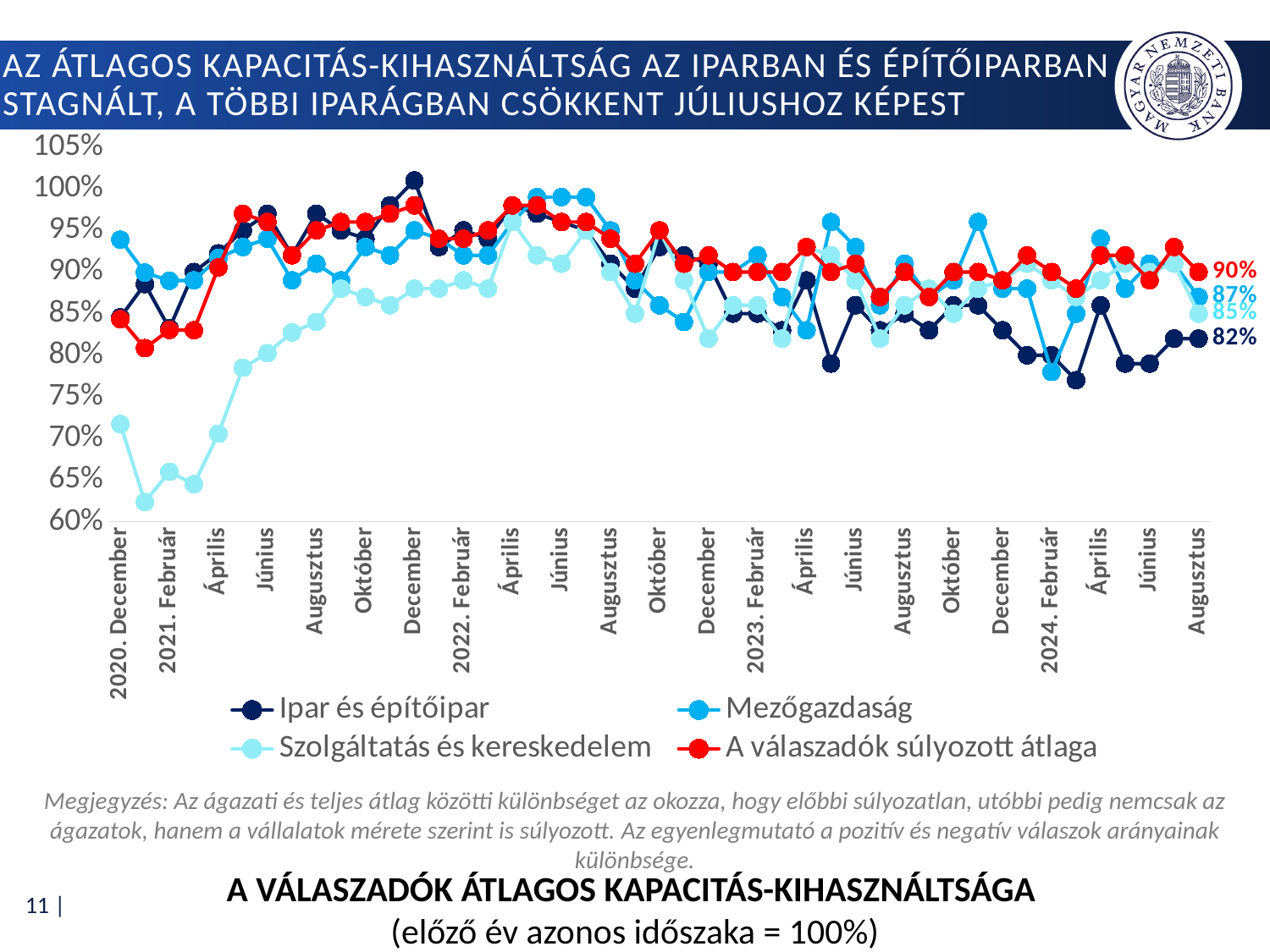
Which series has the highest value at the last point (2024 Augusztus)? A válaszadók súlyozott átlaga How many series does the legend list? 4 What is the title of the chart shown below the legend? A válaszadók átlagos kapacitás-kihasználtsága (előző év azonos időszaka = 100%) What kind of chart is shown on the slide? line chart What is the value of 'Szolgáltatás és kereskedelem' at the last point (2024 Augusztus)? 85% What is the value of 'A válaszadók súlyozott átlaga' at the last point (2024 Augusztus)? 90% What is the value of 'Ipar és építőipar' at the last point (2024 Augusztus)? 82% Is the value for 'Szolgáltatás és kereskedelem' in 2020 December greater or less than 75%? less At the last point (2024 Augusztus), which is larger: 'Mezőgazdaság' or 'Szolgáltatás és kereskedelem'? Mezőgazdaság Which series has the lowest value at the last point (2024 Augusztus)? Ipar és építőipar What is the difference between 'A válaszadók súlyozott átlaga' and 'Ipar és építőipar' at the last point (2024 Augusztus)? 8 percentage points What is the value of 'Mezőgazdaság' at the last point (2024 Augusztus)? 87%